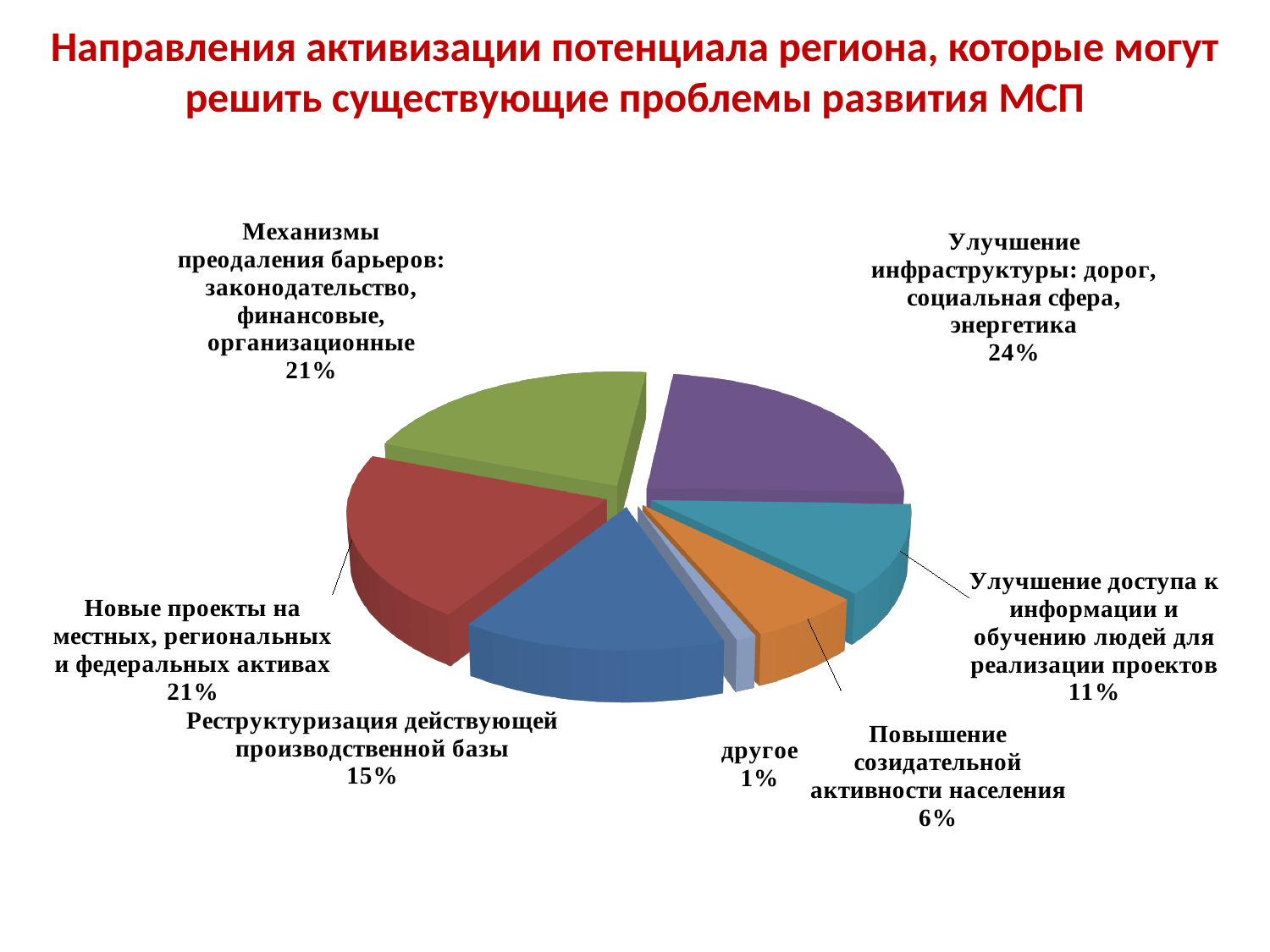
What share of the pie is labelled "Реструктуризация действующей производственной базы"? 15% What colour is the slice for "Улучшение инфраструктуры: дорог, социальная сфера, энергетика"? purple Which category has the largest share of the pie? Улучшение инфраструктуры: дорог, социальная сфера, энергетика What kind of chart is shown on the slide? pie chart Which category has the smallest share of the pie? другое What share of the pie is labelled "Улучшение доступа к информации и обучению людей для реализации проектов"? 11% Which is larger: the share for "Улучшение доступа к информации и обучению людей для реализации проектов" or the share for "Повышение созидательной активности населения"? Улучшение доступа к информации и обучению людей для реализации проектов What share of the pie is labelled "другое"? 1% How many slices does the pie chart have? 7 What is the difference in percentage points between "Улучшение инфраструктуры" (24%) and "Реструктуризация действующей производственной базы" (15%)? 9 percentage points What share of the pie is labelled "Повышение созидательной активности населения"? 6% What share of the pie is labelled "Улучшение инфраструктуры: дорог, социальная сфера, энергетика"? 24%